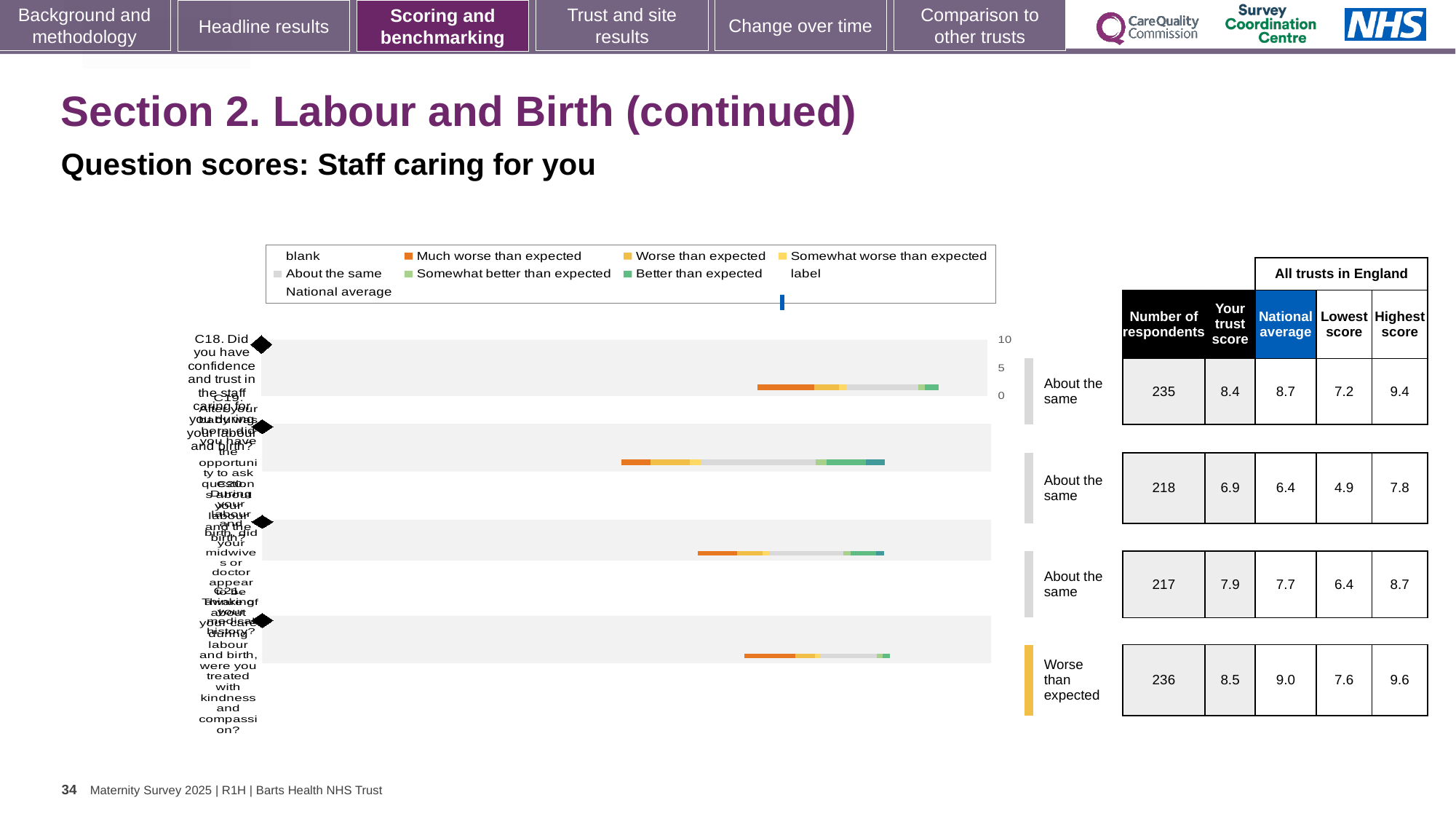
Which benchmark category is shown for the fourth row of the chart? Worse than expected What kind of chart is shown on the slide? bar chart How many question rows are plotted in the chart? 4 What is the difference between the highest score and the lowest score for the first row (C18)? 2.2 For the first row (C18), which is larger: the trust score or the national average? the national average (8.7) What is the highest score across all trusts in England for the fourth row of the chart? 9.6 Which row has the highest number of respondents? the fourth row (236) What is the national average for the first row (C18)? 8.7 What is the number of respondents for the first row (C18, confidence and trust in the staff caring for you)? 235 Which row has the lowest trust score? the second row (6.9) What is the trust score for the second row of the chart? 6.9 What is the trust score for the first row (C18)? 8.4